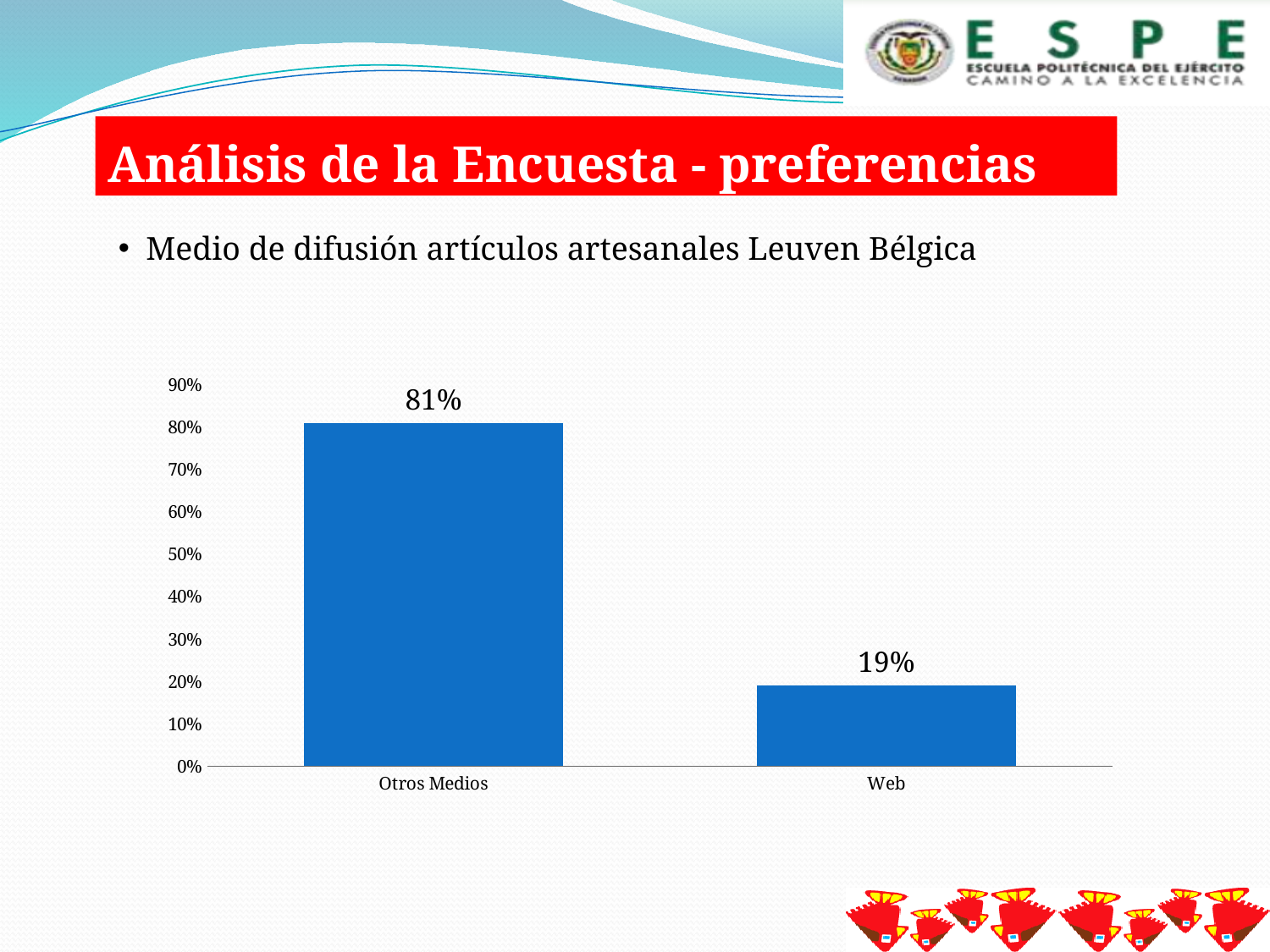
What is the value for Web? 19% What is the highest value shown on the y axis? 90% Is the value for Otros Medios greater or less than 70%? greater Which is larger, the value for Otros Medios or the value for Web? Otros Medios What is the difference between the values for Otros Medios and Web? 62% What is the value for Otros Medios? 81% What colour are the bars in the chart? blue Which category has the highest value? Otros Medios How many categories are shown on the x axis? 2 Which category has the lowest value? Web Is the value for Web greater or less than 30%? less What kind of chart is shown on the slide? bar chart